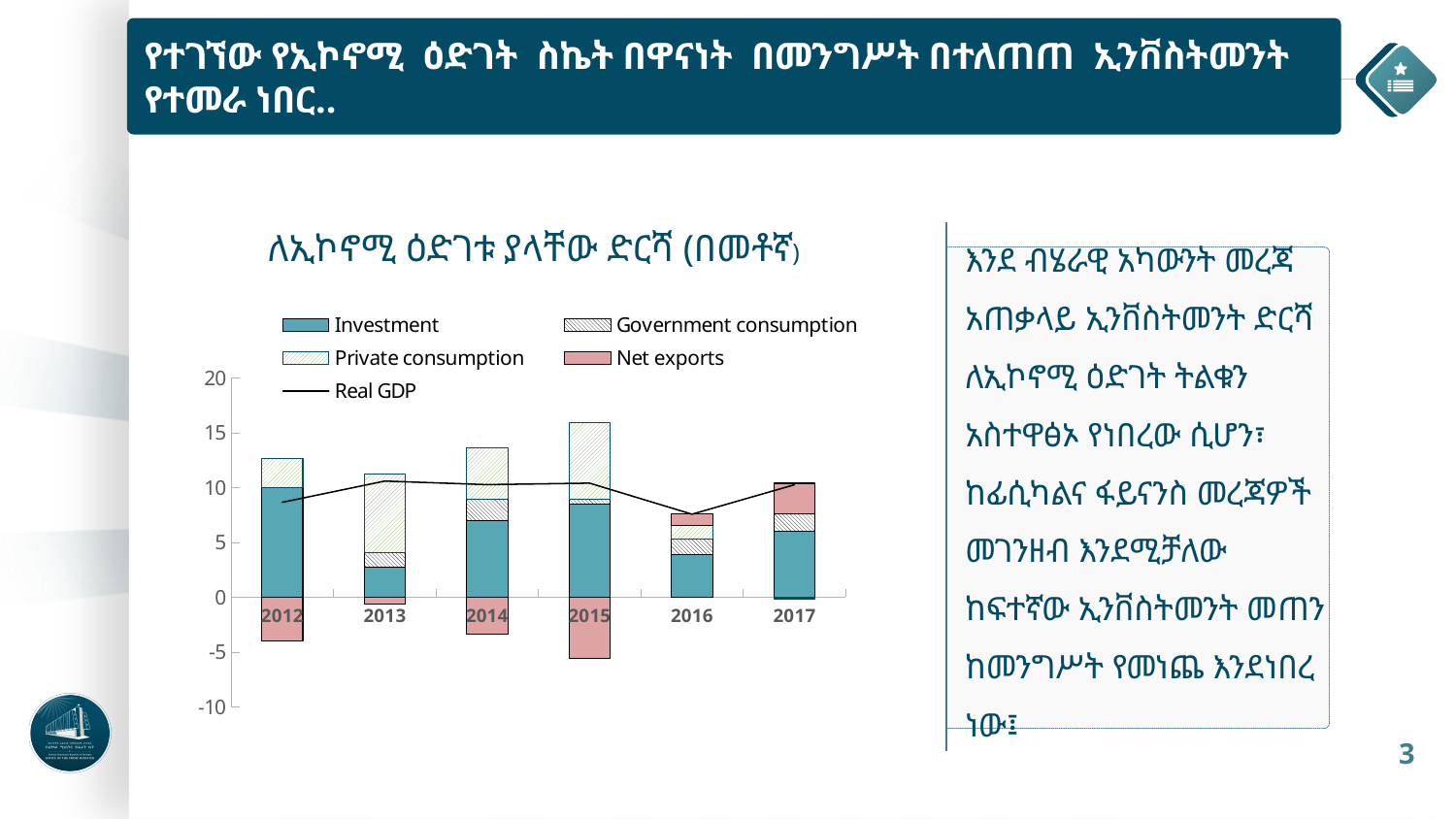
How many series does the chart's legend list? 5 Does the Real GDP line rise or fall from 2015 to 2016? fall In which year is the Net exports value the lowest (most negative)? 2015 Is the Investment value for 2013 greater or less than 5? less Is the Net exports value for 2015 greater or less than 0? less Is the Real GDP value for 2016 greater or less than 10? less How many years are shown on the x axis of the chart? 6 In which year is the Investment bar segment the tallest? 2012 What kind of chart is shown on the slide? Stacked bar chart with a line Which series is shown in the legend with a solid pink/red fill? Net exports Which series in the chart is drawn as a line rather than bars? Real GDP